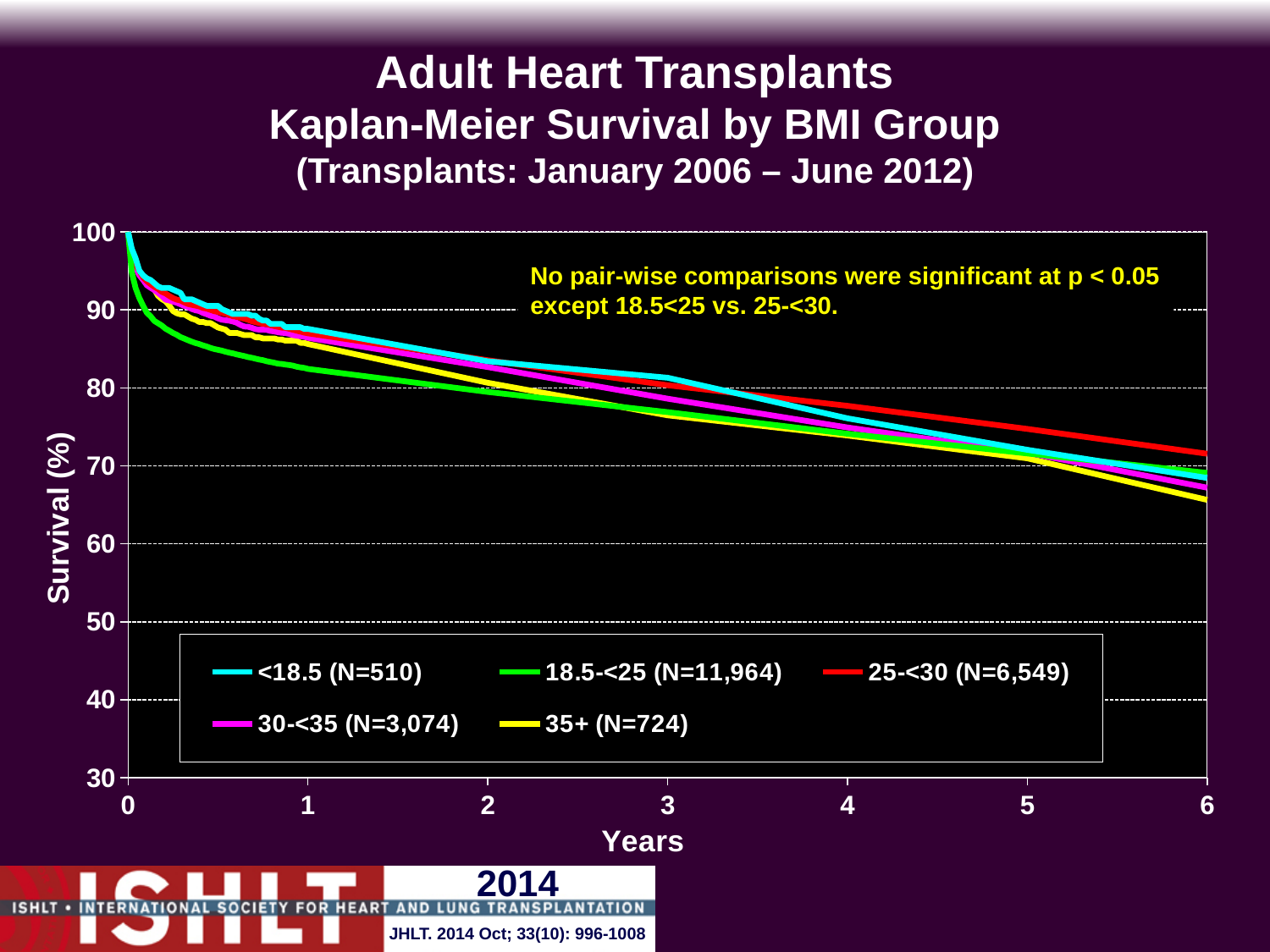
At 1 year, which group has higher survival: <18.5 or 18.5-<25? <18.5 Is the survival for the 35+ group at 6 years greater or less than 70? less What is the label of the y axis? Survival (%) Is the survival for the 18.5-<25 group at 3 years greater or less than 80? less Which BMI group has the lowest survival at 1 year? 18.5-<25 What kind of chart is shown on the slide? line chart How many BMI groups (series) does the legend list? 5 According to the legend, how many patients (N) are in the 18.5-<25 BMI group? 11,964 Is the survival for the 25-<30 group at 6 years greater or less than 70? greater Which BMI group has the highest survival at 6 years? 25-<30 Which BMI group has the lowest survival at 6 years? 35+ Do the survival curves rise or fall as years since transplant increase? fall